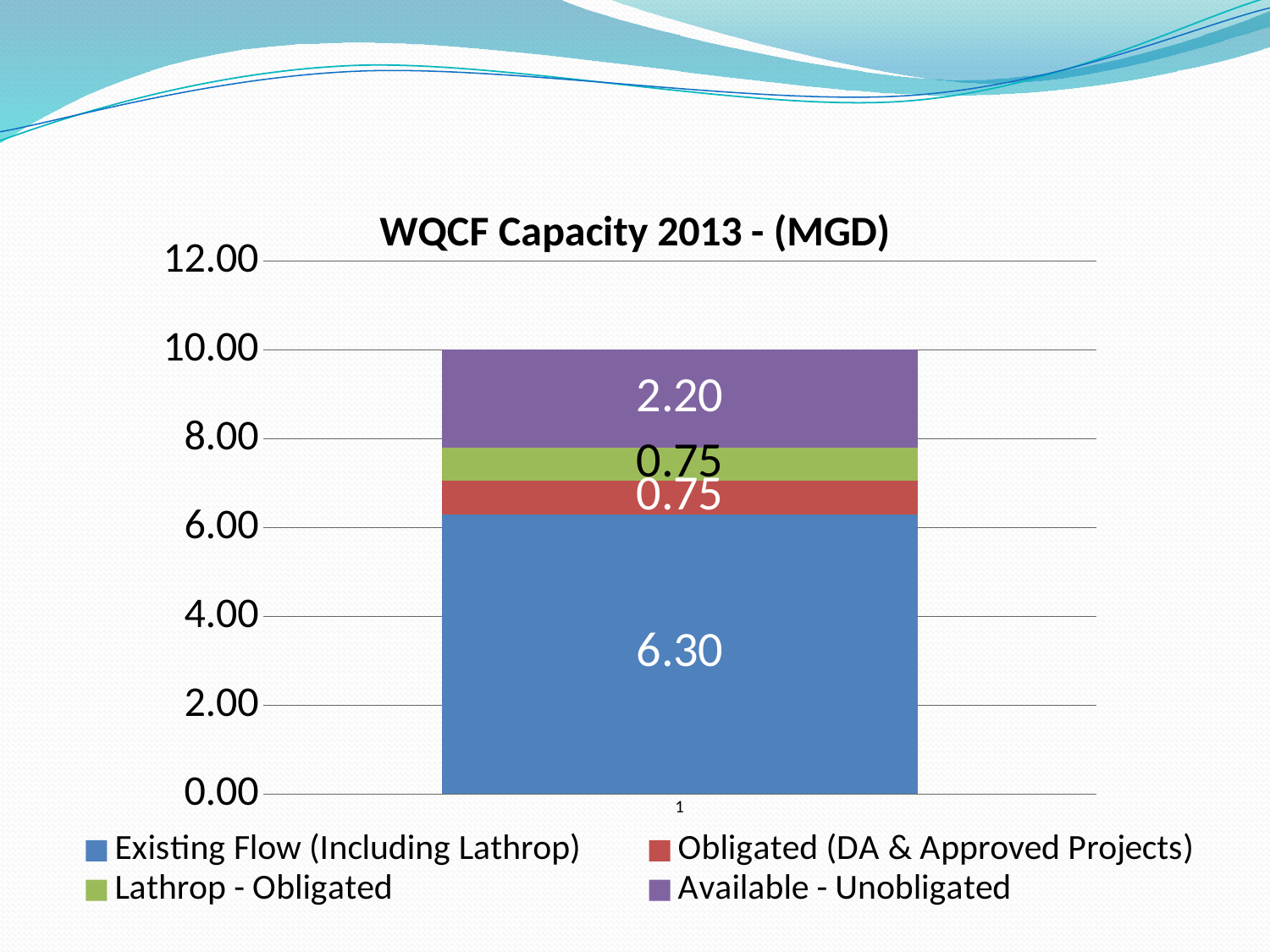
What is the value for Lathrop - Obligated? 0.75 What is the difference between the Existing Flow (Including Lathrop) value and the Available - Unobligated value? 4.10 How many bars are plotted in the chart? 1 What kind of chart is shown on the slide? stacked bar chart What is the total of the stacked bar? 10.00 What is the value for Available - Unobligated? 2.20 Which is larger, the Available - Unobligated value or the Lathrop - Obligated value? Available - Unobligated What is the value for Existing Flow (Including Lathrop)? 6.30 Which series has the largest value in the stacked bar? Existing Flow (Including Lathrop) How many series does the legend list? 4 What is the value for Obligated (DA & Approved Projects)? 0.75 What is the title of the chart? WQCF Capacity 2013 - (MGD)